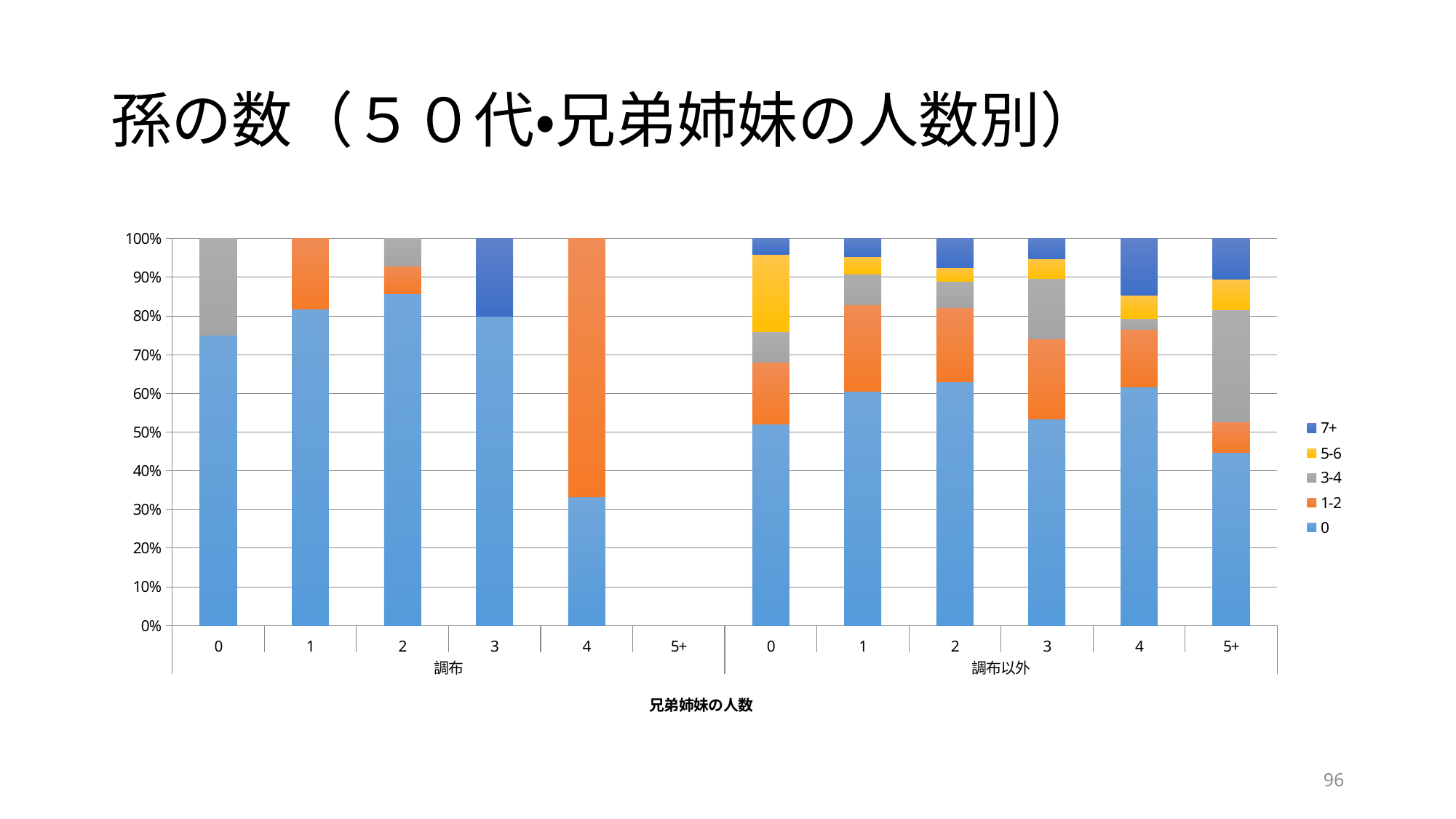
What kind of chart is shown on the slide? Stacked bar chart For sibling count 4, which group has the larger share for the '0' series, 調布 or 調布以外? 調布以外 Is the share of the '0' series for sibling count 5+ in the 調布以外 group greater or less than 50%? less Is the share of the '0' series for sibling count 4 in the 調布 group greater or less than 40%? less What is the title of the chart's horizontal axis? 兄弟姉妹の人数 How many series does the legend list? 5 Which two groups are the bars divided into along the x axis? 調布 and 調布以外 Is the share of the '0' series for sibling count 2 in the 調布以外 group greater or less than 60%? greater Within the 調布 group, which sibling count has the smallest share for the '0' series? 4 Within the 調布以外 group, which sibling count has the smallest share for the '0' series? 5+ For sibling count 0, which group has the larger share for the '0' series, 調布 or 調布以外? 調布